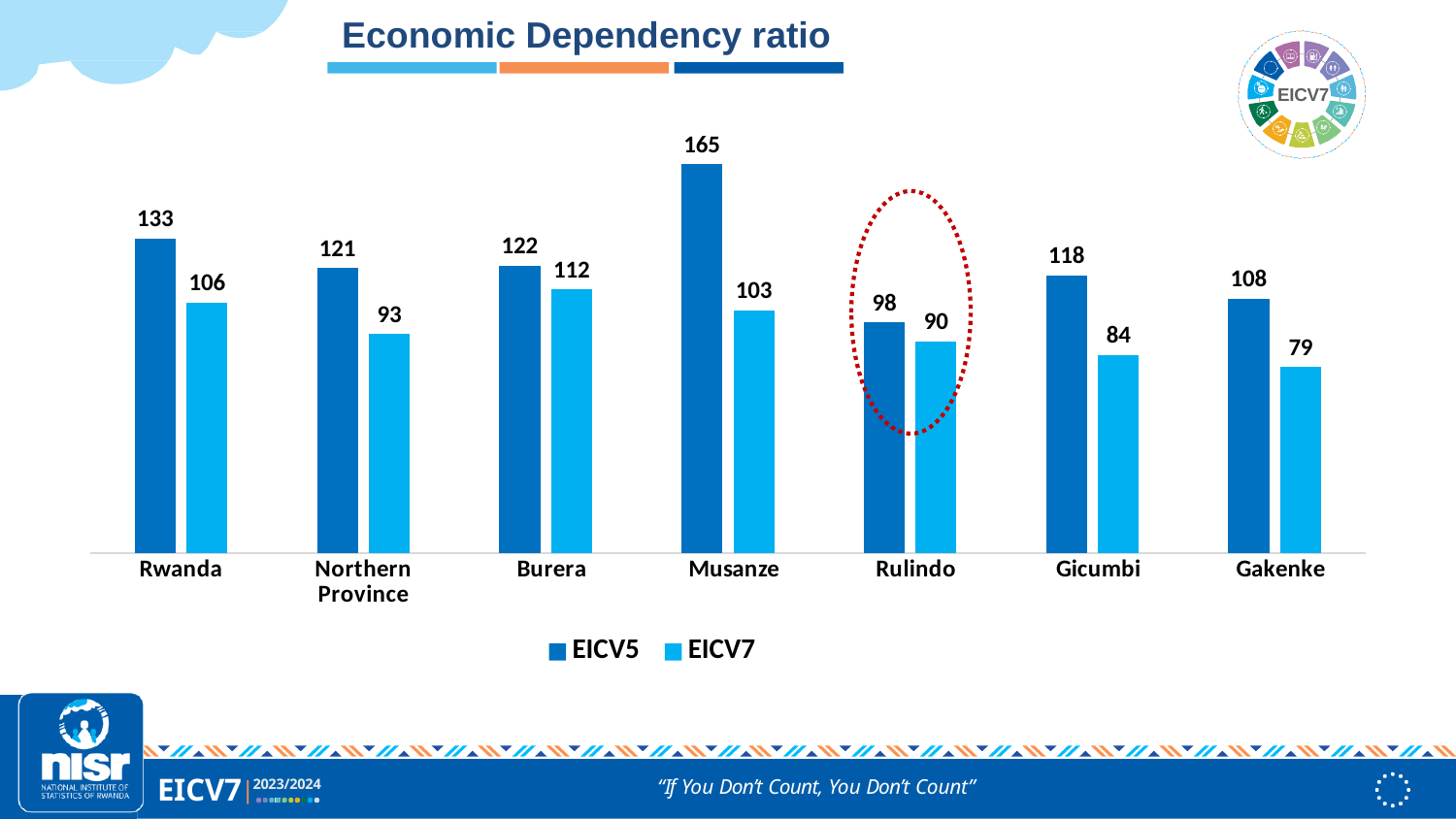
What kind of chart is shown on the slide? Bar chart What is the title of the chart? Economic Dependency ratio Which is larger, the EICV7 value for Burera or the EICV7 value for Gicumbi? Burera How many series does the legend list? 2 How many categories are shown on the x axis? 7 What is the EICV5 economic dependency ratio for Musanze? 165 Which category is highlighted with a red dotted circle? Rulindo What is the EICV7 economic dependency ratio for Rwanda? 106 What is the difference between the EICV5 and EICV7 values for Northern Province? 28 What is the EICV7 value for Gakenke? 79 Which category has the highest EICV5 value? Musanze Which category has the lowest EICV7 value? Gakenke